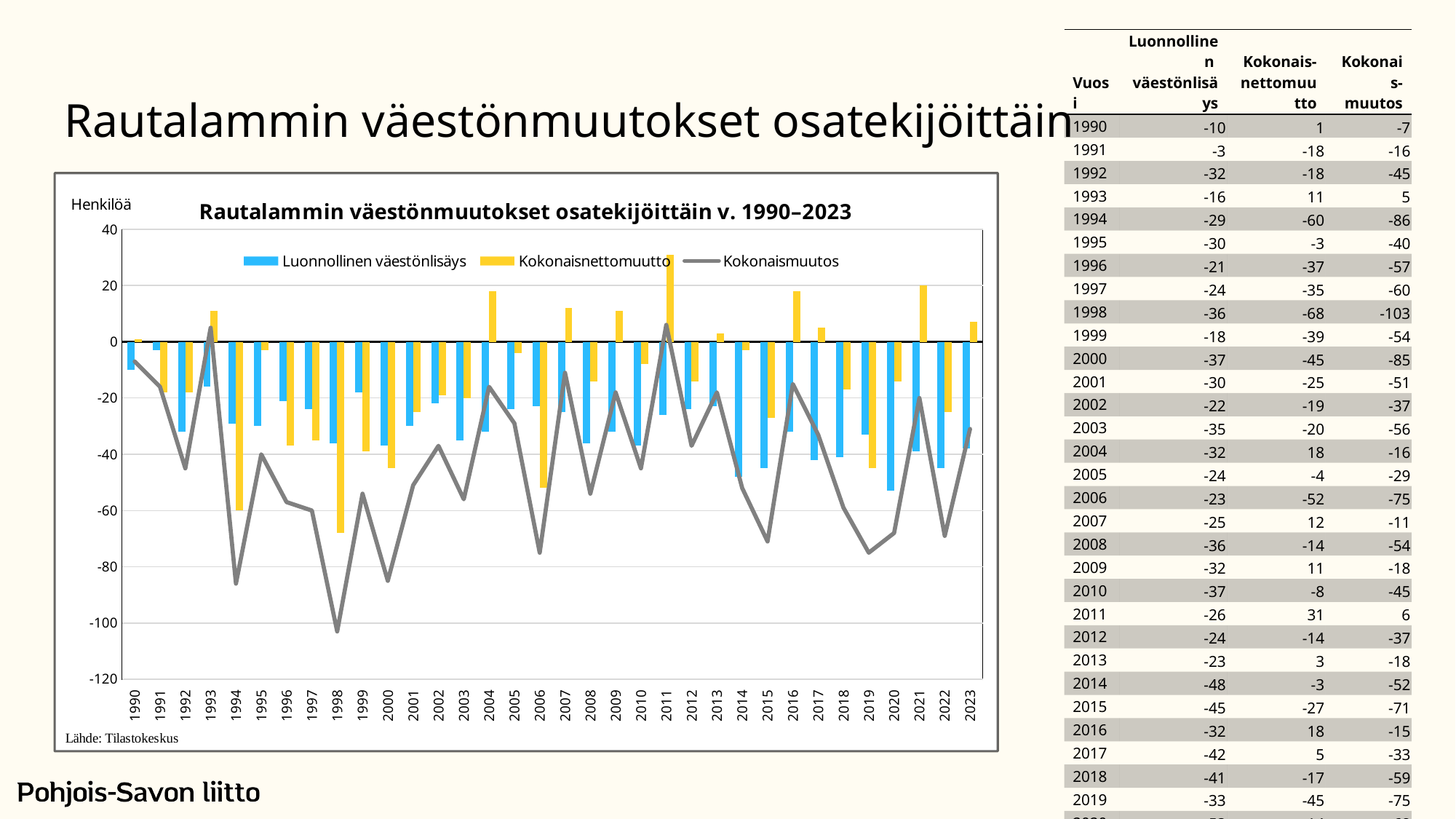
What is the Kokonaisnettomuutto value for 2011? 31 What is the Kokonaismuutos value for 1998? -103 In which year is the Kokonaisnettomuutto bar the highest? 2011 Is the Kokonaismuutos value for 1994 greater or less than -80? less Which year has the larger Kokonaisnettomuutto value, 2004 or 2011? 2011 Is the Luonnollinen väestönlisäys value for 2014 greater or less than -40? less What is the unit label shown above the vertical axis of the chart? Henkilöä In which year is the Kokonaismuutos line at its lowest point? 1998 How many series does the chart legend list? 3 What kind of chart is shown on the slide? A combined bar and line chart Which series is drawn as a grey line in the chart? Kokonaismuutos How many years are shown on the x axis of the chart? 34